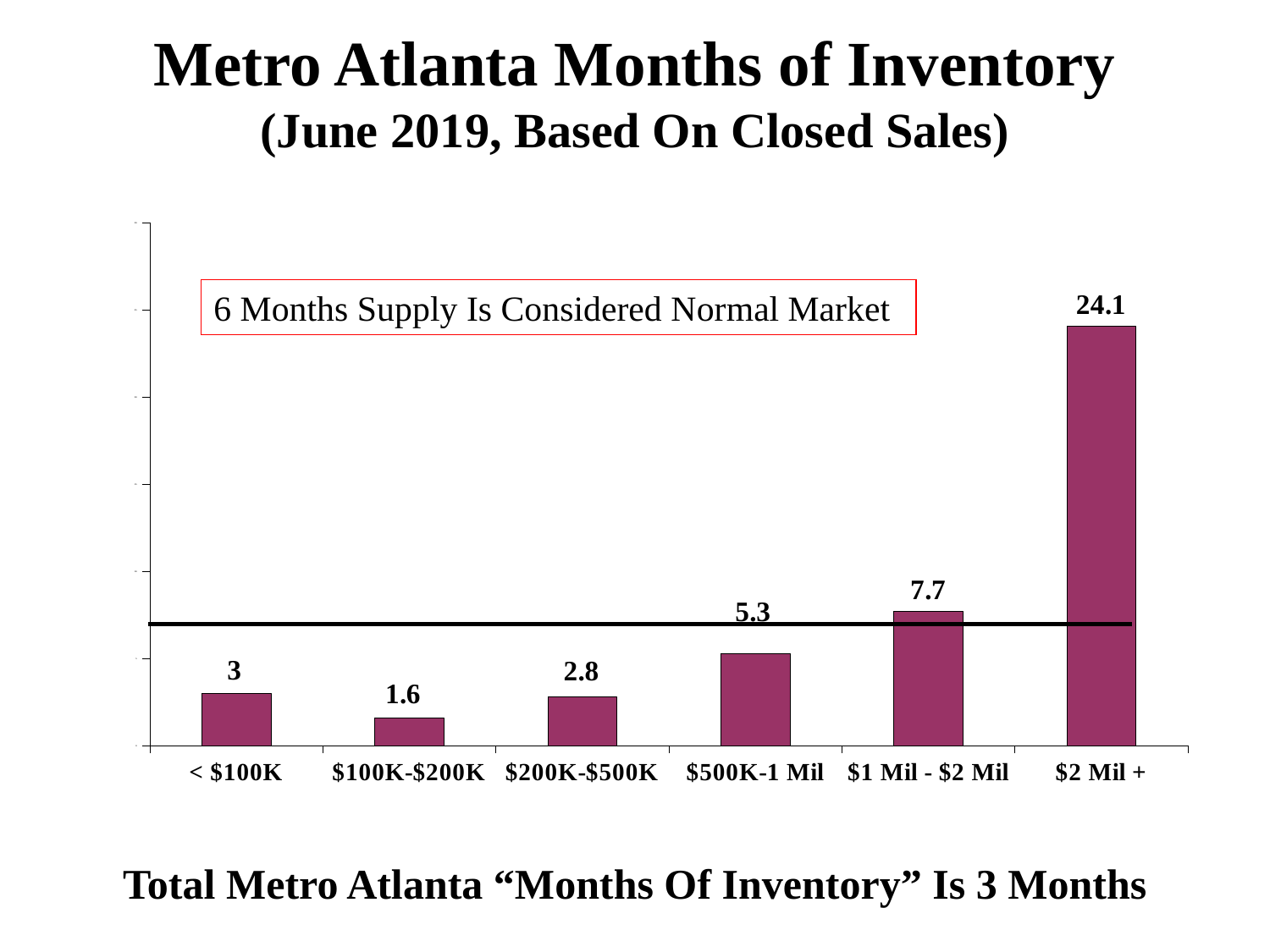
What is the difference in months of inventory between the < $100K and $200K-$500K price ranges? 0.2 What is the months of inventory value for the $2 Mil + price range? 24.1 Which price range has the lowest months of inventory? $100K-$200K How many price range categories are shown on the chart? 6 What is the months of inventory value for the $500K-1 Mil price range? 5.3 According to the text box on the chart, how many months of supply is considered a normal market? 6 Months What type of chart is shown on the slide? Bar chart Which has a larger months of inventory value, $500K-1 Mil or $1 Mil - $2 Mil? $1 Mil - $2 Mil Do the months of inventory values generally rise or fall as the price range increases from $200K-$500K to $2 Mil +? Rise Which price range has the highest months of inventory? $2 Mil + What is the difference in months of inventory between the $2 Mil + and $1 Mil - $2 Mil price ranges? 16.4 What is the months of inventory value for the $100K-$200K price range? 1.6